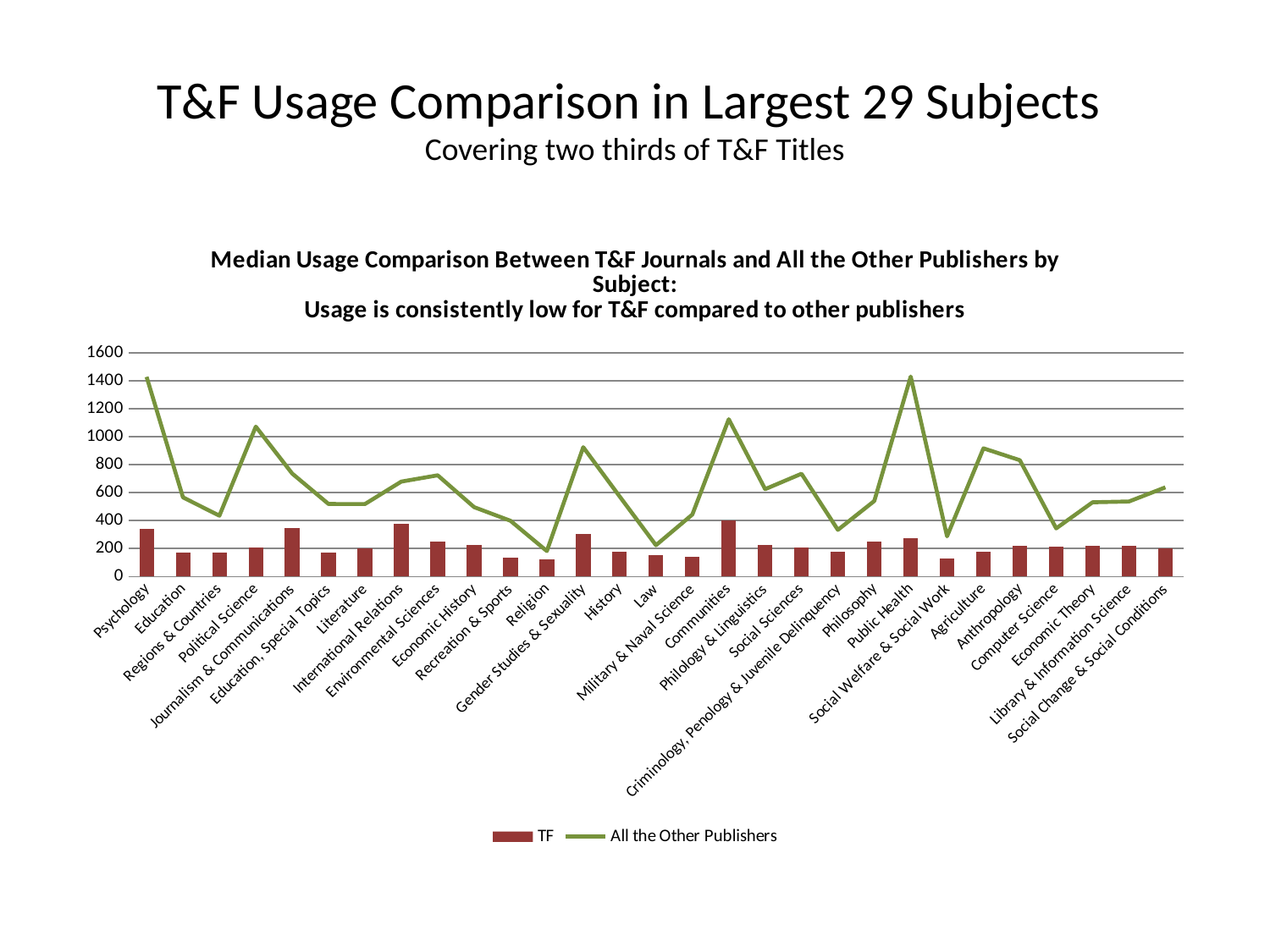
What kind of chart is this? A combined bar and line chart Which series is drawn as a green line? All the Other Publishers Is the All the Other Publishers value for Political Science greater or less than 800? greater Which subject has the highest TF value? Communities Is the TF value for Communities greater or less than 300? greater Is the All the Other Publishers value for Psychology greater or less than 1200? greater Which subject has the lowest value for All the Other Publishers? Religion For All the Other Publishers, which is larger: Psychology or Education? Psychology How many series does the legend list? 2 What are the two series named in the legend? TF and All the Other Publishers How many subjects are plotted along the x axis? 29